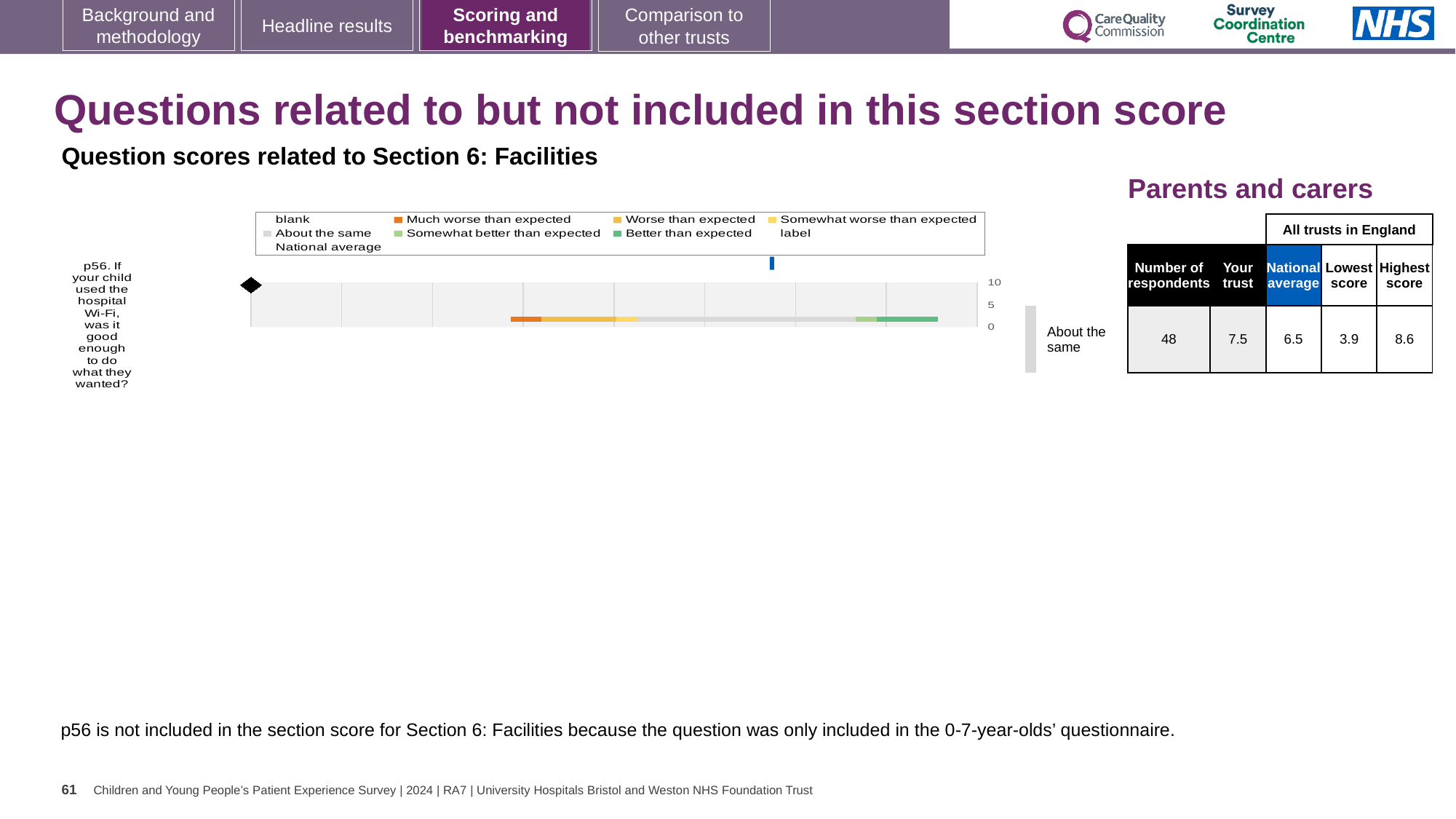
What is the highest value shown on the chart's axis? 10 How many questions (categories) are plotted in the chart? 1 What kind of chart is used to show the p56 question score? bar chart What is the difference between the Highest score and the Lowest score for p56 in the table? 4.7 In the table beside the chart, how many respondents answered p56? 48 In the table beside the chart, what is the Highest score among all trusts in England for p56? 8.6 What benchmark category is shown next to the chart for p56? About the same In the table beside the chart, what is the National average score for p56? 6.5 In the table beside the chart, what is the 'Your trust' score for p56? 7.5 In the table beside the chart, what is the Lowest score among all trusts in England for p56? 3.9 Is the 'Your trust' score for p56 higher or lower than the National average? higher Which question is plotted in the chart? p56. If your child used the hospital Wi-Fi, was it good enough to do what they wanted?